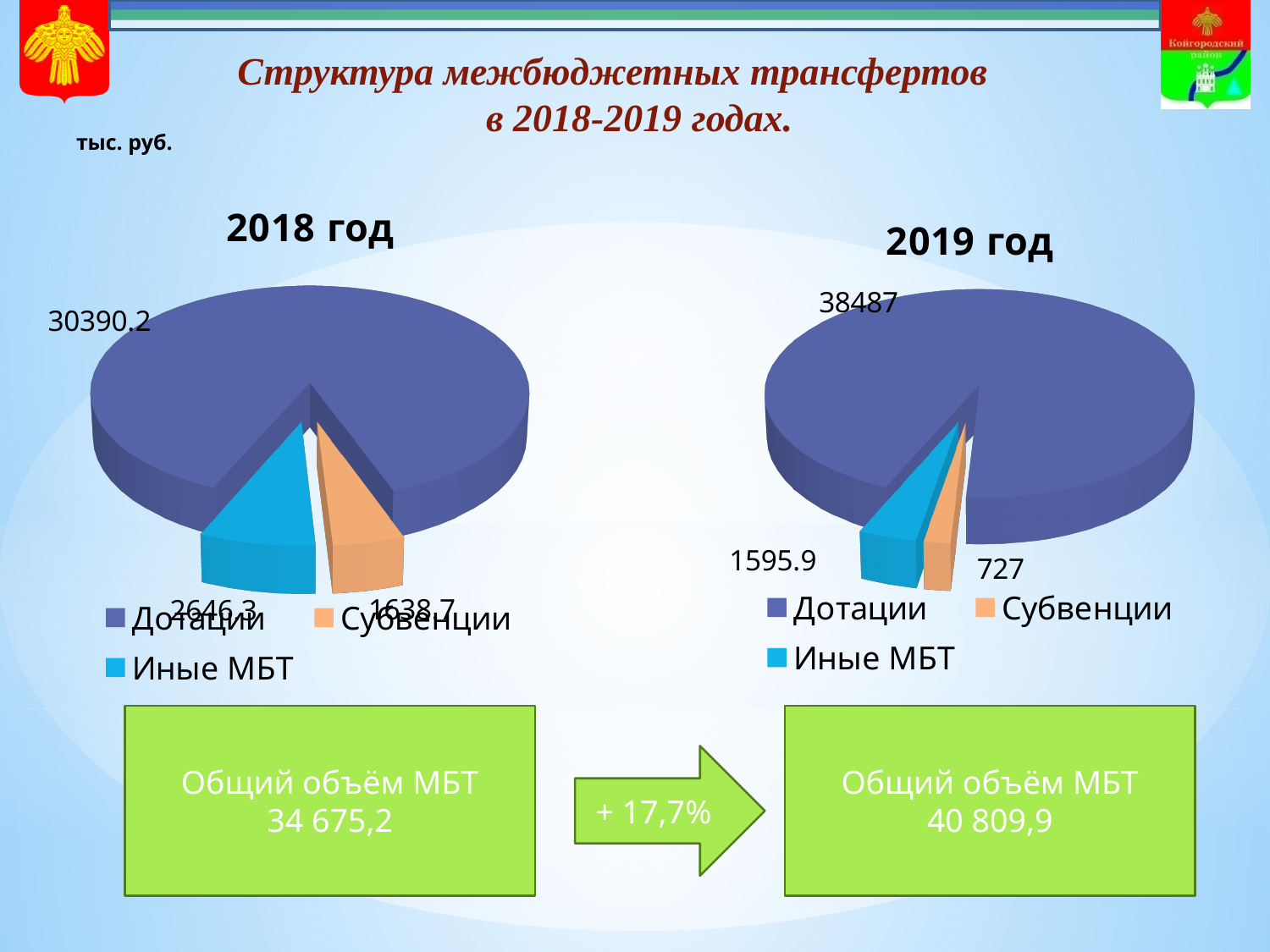
In the 2019 год pie chart, which category has the smallest slice? Субвенции In the 2019 год pie chart, what is the value for Иные МБТ? 1595.9 How many entries does the legend of the 2018 год chart list? 3 In the 2019 год pie chart, what is the value for Субвенции? 727 In the 2019 год pie chart, which category has the largest slice? Дотации How many slices does the 2019 год pie chart have? 3 What type of chart is used to show the 2018 год data? Pie chart In the 2019 год pie chart, what is the difference between the values for Иные МБТ and Субвенции? 868.9 In the 2019 год pie chart, which is larger: Иные МБТ or Субвенции? Иные МБТ In the 2019 год pie chart, what is the value for Дотации? 38487 In the 2018 год pie chart, what is the value for Дотации? 30390.2 In the 2018 год pie chart, which category has the smallest slice? Субвенции